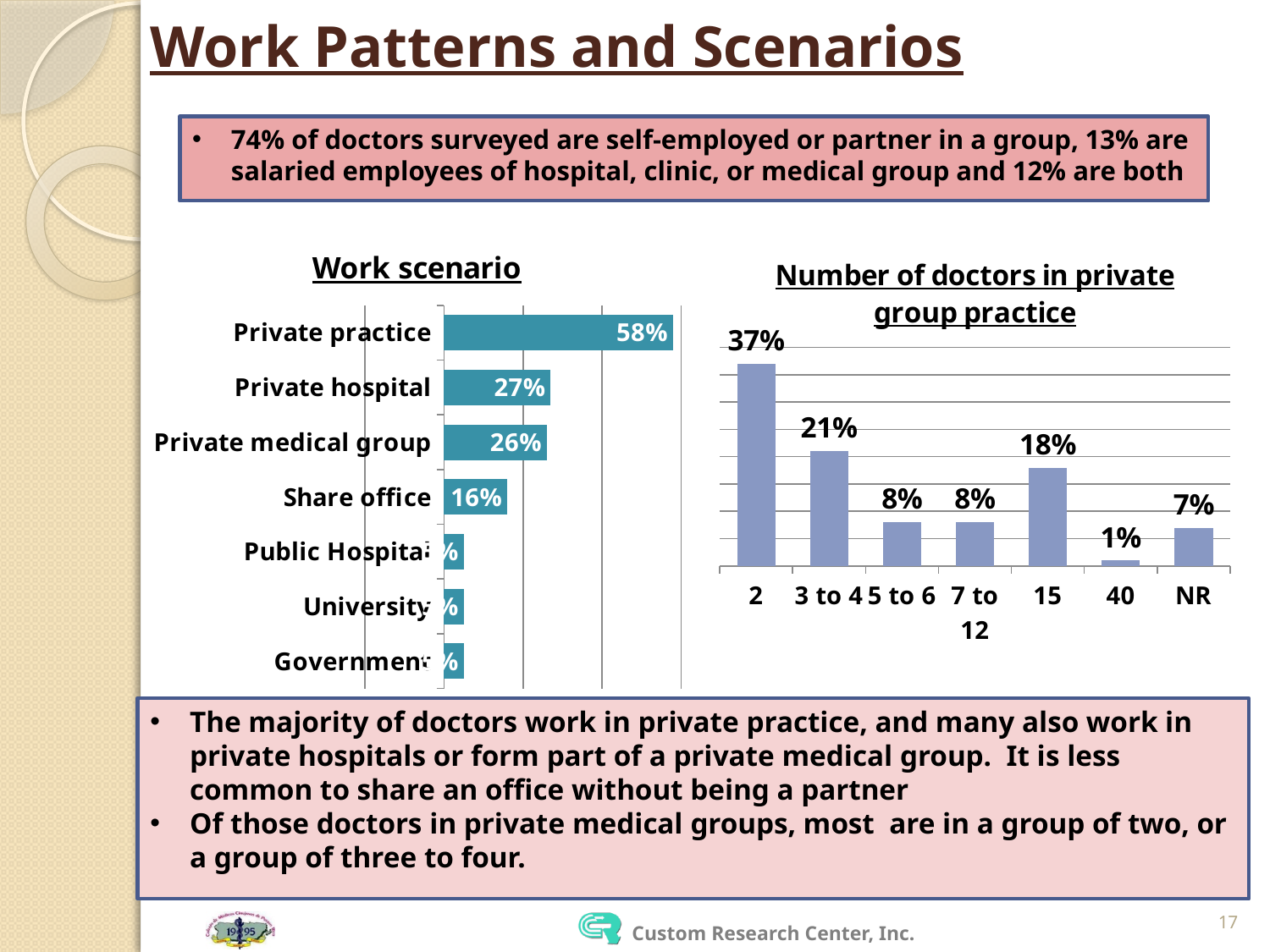
In the Work scenario chart, what is the value for Private practice? 58% In the Number of doctors in private group practice chart, what is the value for 3 to 4? 21% In the Work scenario chart, which category has the highest value? Private practice In the Work scenario chart, what is the value for Share office? 16% In the Work scenario chart, what is the difference between Private practice and Private hospital? 31% In the Number of doctors in private group practice chart, what is the value for 15? 18% In the Number of doctors in private group practice chart, which category has the lowest value? 40 In the Number of doctors in private group practice chart, which is larger, the value for 15 or the value for NR? 15 What kind of chart is the Work scenario chart? Bar chart In the Work scenario chart, what is the value for Private medical group? 26% In the Work scenario chart, how many categories are shown? 7 In the Number of doctors in private group practice chart, what is the difference between the values for 2 and 3 to 4? 16%